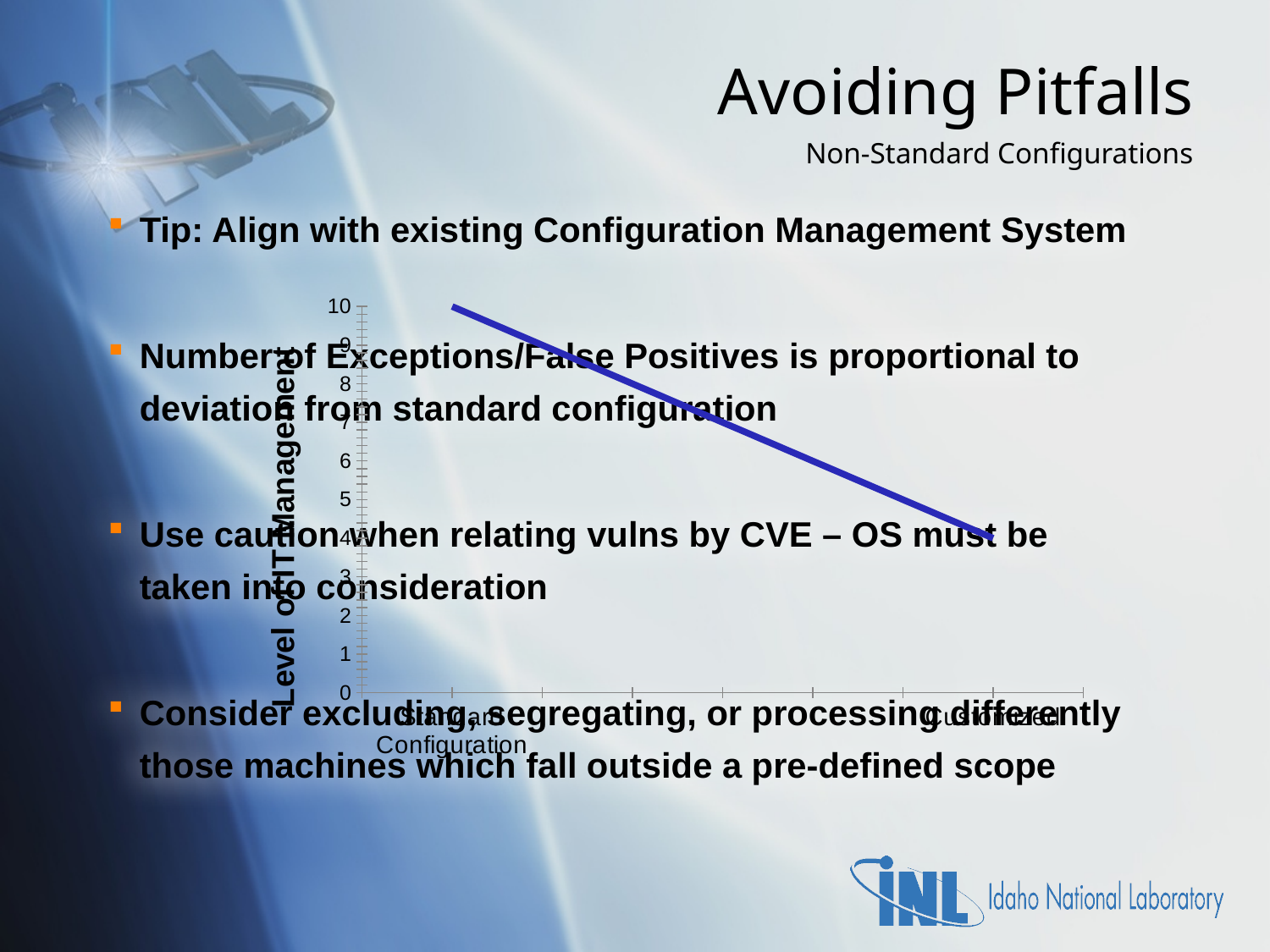
Does the line in the chart rise or fall from Standard Configuration to Customized? fall Is the value for Customized greater or less than 6? less What is the highest tick value shown on the vertical axis of the chart? 10 Which category has the higher Level of IT Management, Standard Configuration or Customized? Standard Configuration What is the title of the vertical axis of the chart? Level of IT Management How many categories are shown on the x axis of the chart? 2 Which category has the highest Level of IT Management in the chart? Standard Configuration What kind of chart is shown on the slide? line chart Which category has the lowest Level of IT Management in the chart? Customized Is the value for Standard Configuration greater or less than 8? greater